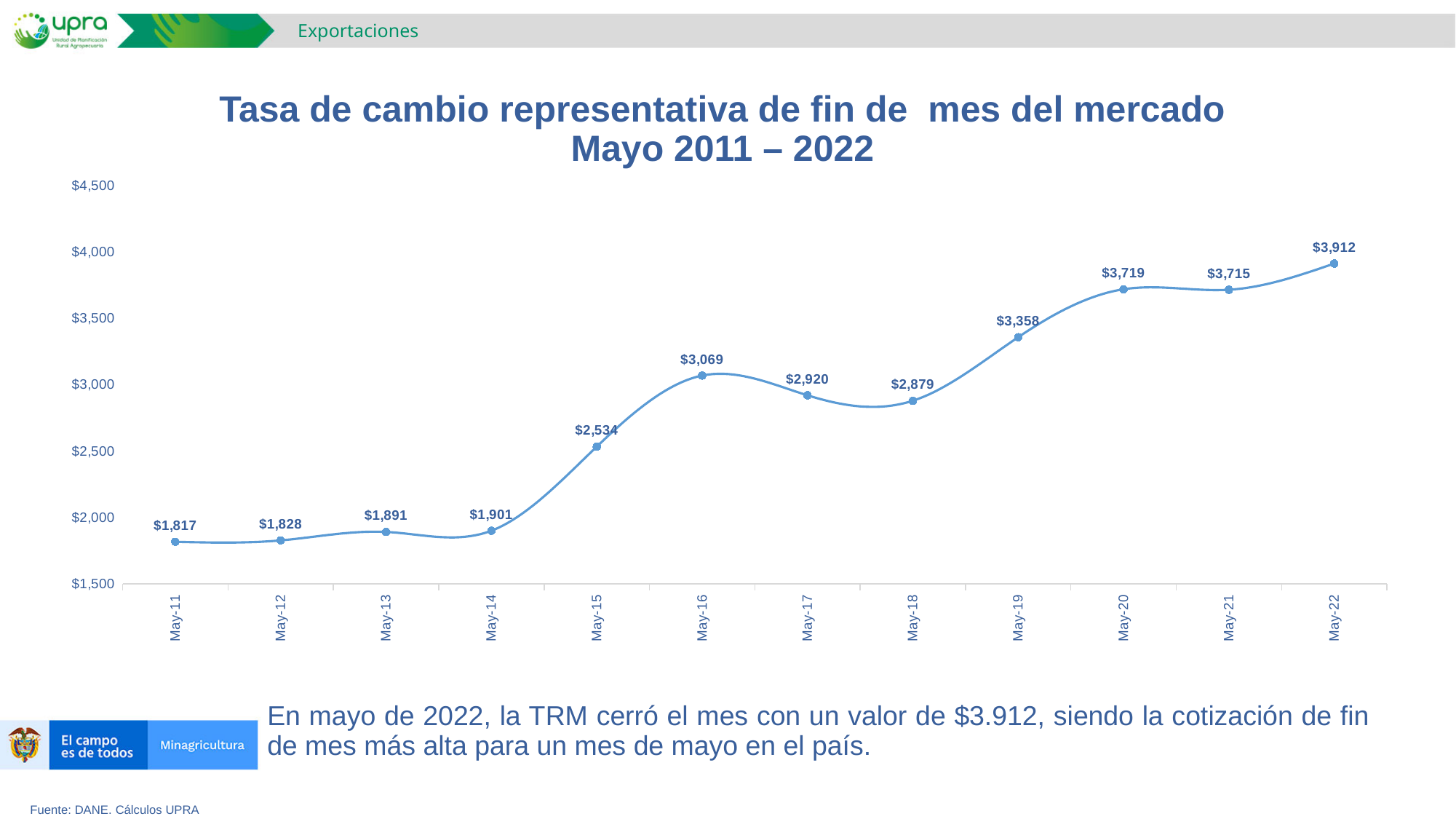
What kind of chart is shown on the slide? Line chart What is the difference between the values for May-22 and May-21? $197 Is the value for May-20 greater or less than $3,500? greater Which month has the lowest value? May-11 How many data points are plotted on the chart? 12 Which month has the highest value? May-22 What is the value for May-11? $1,817 What is the value for May-19? $3,358 Which is larger, the value for May-17 or the value for May-18? May-17 Do the values generally rise or fall from May-11 to May-22? Rise What is the value for May-15? $2,534 What is the difference between the values for May-16 and May-15? $535